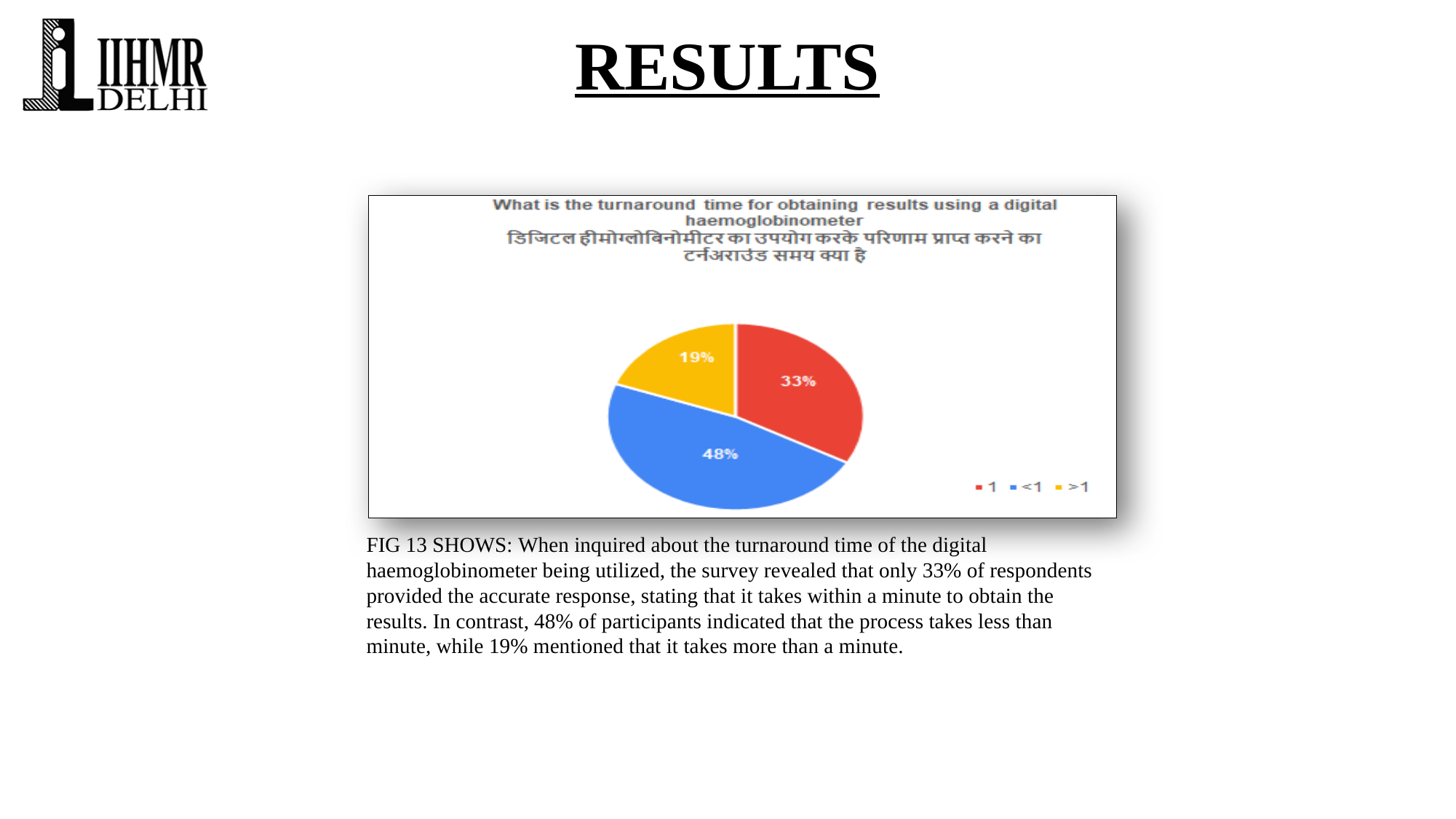
How many slices does the pie chart have? 3 What is the difference in percentage points between the "1" slice and the ">1" slice? 14 How many entries does the legend list? 3 What is the difference in percentage points between the "<1" slice and the "1" slice? 15 What share of the pie does the "1" slice represent? 33% Which slice is larger, "1" or ">1"? 1 What colour is the "<1" slice in the pie chart? Blue What share of the pie does the ">1" slice represent? 19% What kind of chart is shown on the slide? Pie chart What share of the pie does the "<1" slice represent? 48% Which category has the smallest slice of the pie? >1 Which category has the largest slice of the pie? <1